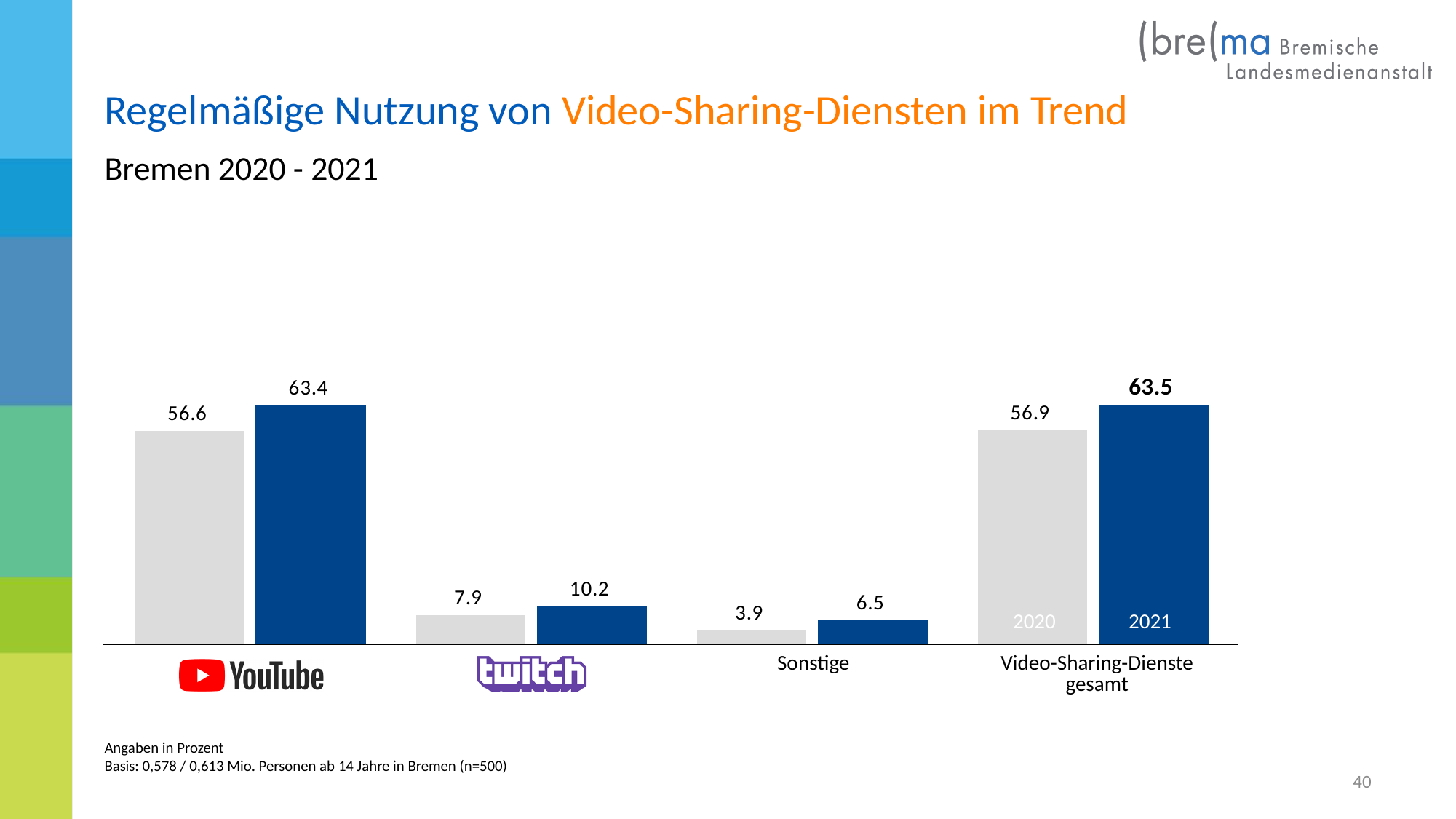
Which is larger: the 2020 value for Twitch or the 2021 value for Sonstige? 2020 value for Twitch How many series (years) are shown in the chart? 2 What is the value for Twitch in 2020? 7.9 Which category has the highest value in 2021? Video-Sharing-Dienste gesamt Which category has the lowest value in 2020? Sonstige What is the value for Video-Sharing-Dienste gesamt in 2020? 56.9 What is the value for YouTube in 2021? 63.4 How many categories are shown on the x axis? 4 What is the difference between the 2021 and 2020 values for Twitch? 2.3 What is the value for Sonstige in 2021? 6.5 What kind of chart is shown on the slide? Bar chart What is the difference between the 2021 and 2020 values for YouTube? 6.8